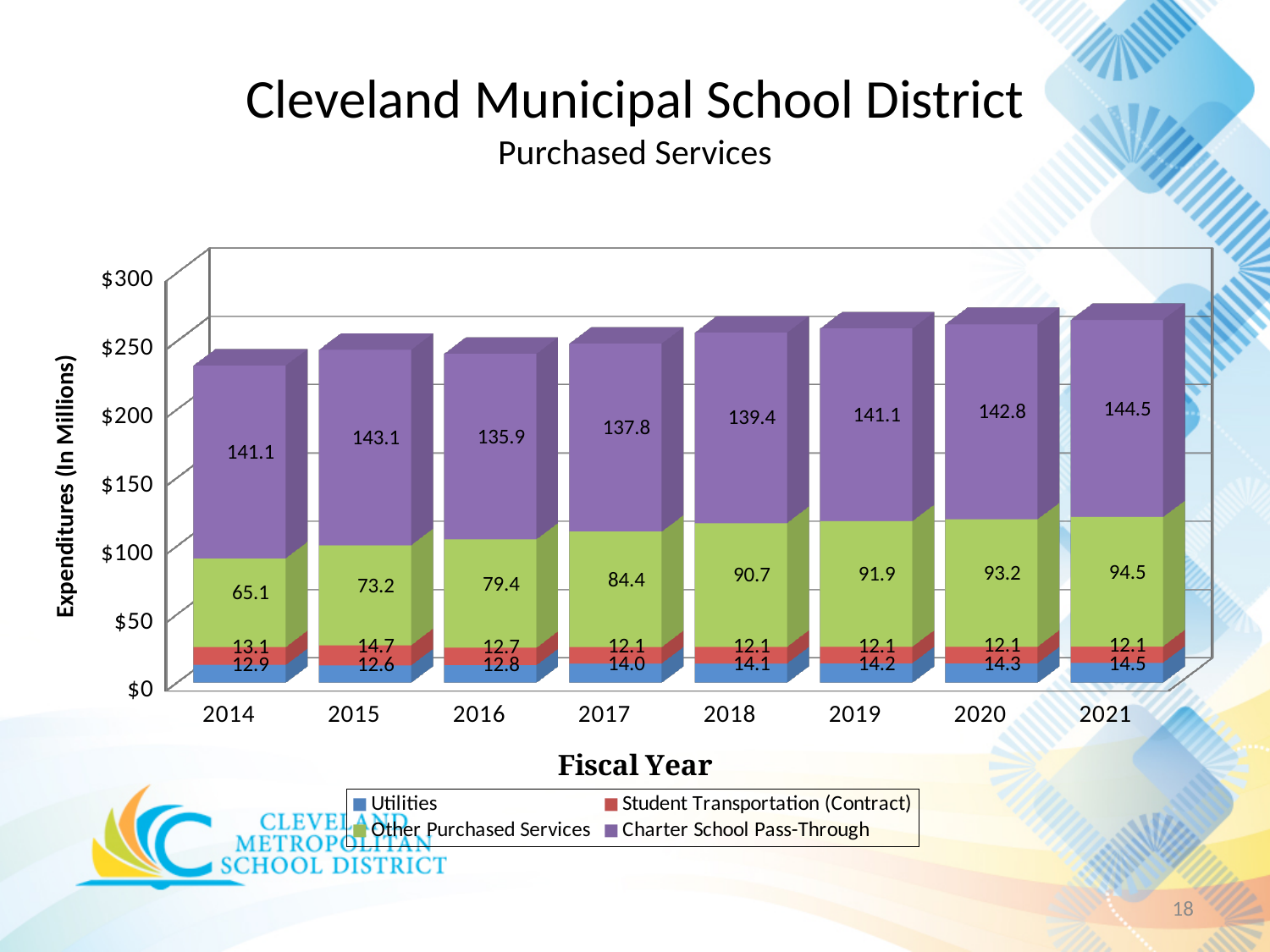
How many series does the legend list? 4 In which fiscal year is Charter School Pass-Through lowest? 2016 What is the value for Utilities in fiscal year 2021? 14.5 What is the difference between Other Purchased Services in 2021 and in 2014? 29.4 Does Other Purchased Services rise or fall from 2014 to 2021? Rises Which is larger, Charter School Pass-Through in 2015 or in 2017? 2015 What is the total of the stacked bar for fiscal year 2021? 265.6 What kind of chart is shown on the slide? Stacked bar chart How many fiscal years are shown on the x axis? 8 What is the value for Charter School Pass-Through in fiscal year 2018? 139.4 What is the value for Other Purchased Services in fiscal year 2014? 65.1 In which fiscal year is Other Purchased Services highest? 2021